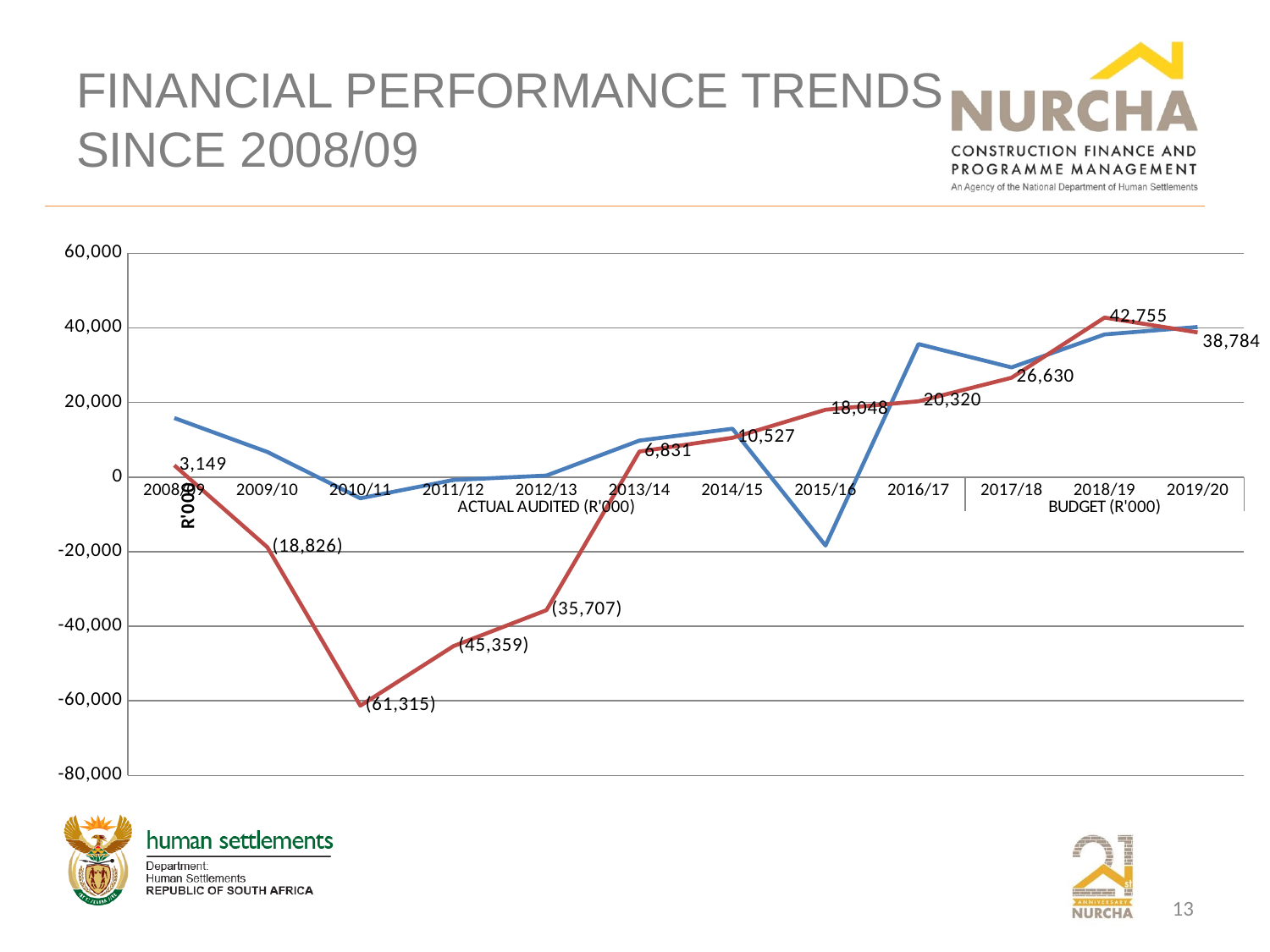
What is the labelled value of the red line for 2009/10? (18,826) Does the red line rise or fall from 2013/14 to 2018/19? Rises In which year does the red line reach its lowest value? 2010/11 How many financial years are plotted along the x axis? 12 Is the value of the blue line for 2015/16 greater or less than 0? less What is the labelled value of the red line for 2018/19? 42,755 What are the two group labels shown beneath the x axis? ACTUAL AUDITED (R'000) and BUDGET (R'000) By how much does the red line's value for 2018/19 exceed its value for 2019/20? 3,971 What is the labelled value of the red line for 2010/11? (61,315) In which year does the red line reach its highest value? 2018/19 Which year has the larger red-line value, 2016/17 or 2017/18? 2017/18 What kind of chart is shown on the slide? Line chart